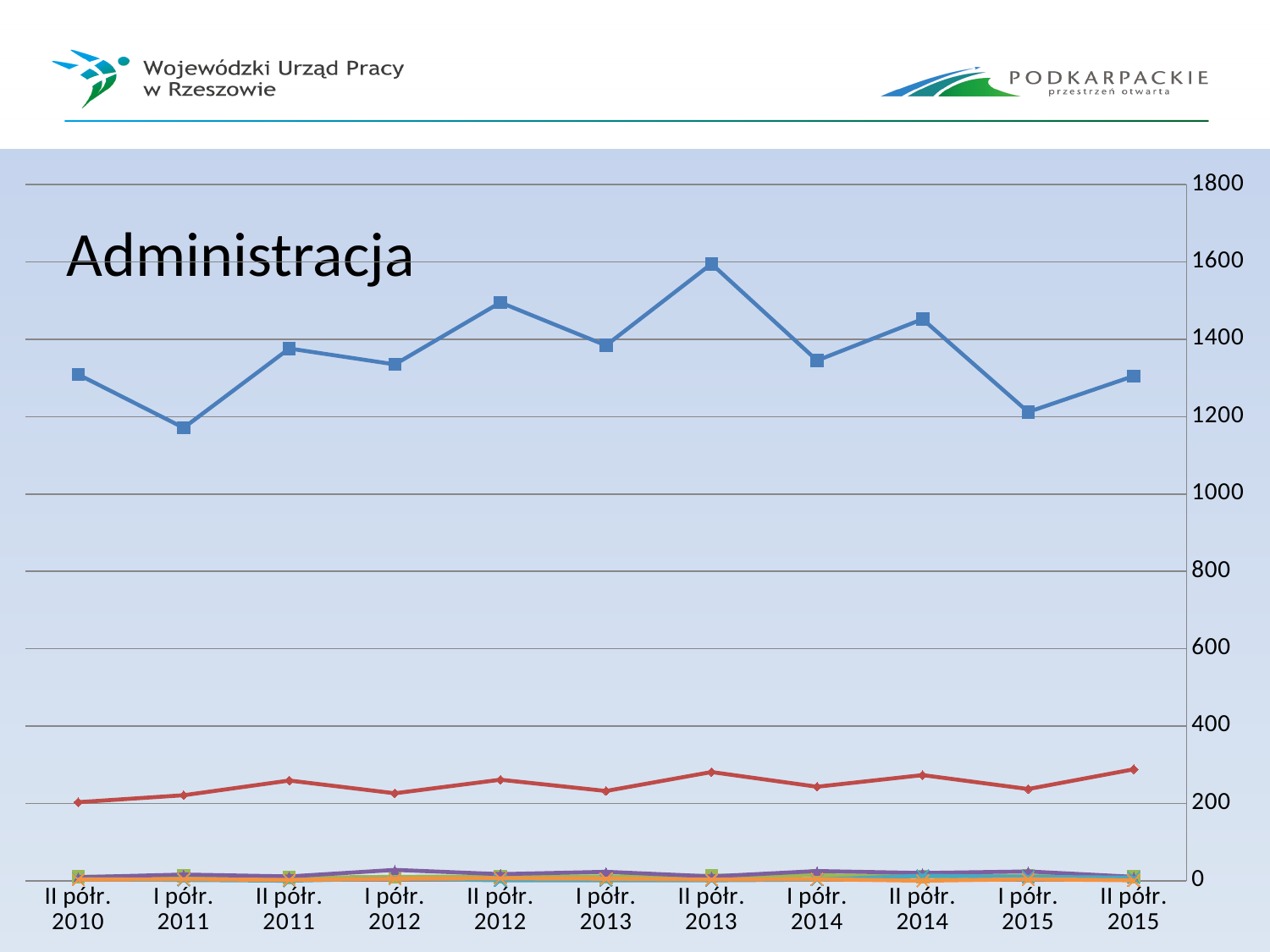
Does the blue line rise or fall from II półr. 2013 to I półr. 2014? fall What kind of chart is shown on the slide? line chart Which is larger for II półr. 2012: the value of the blue line or the value of the red line? the blue line What is the title of the chart? Administracja In which period does the blue (top) line reach its highest value? II półr. 2013 How many half-year periods are shown on the x axis? 11 Does the blue line rise or fall from I półr. 2015 to II półr. 2015? rise In which period does the blue (top) line reach its lowest value? I półr. 2011 Is the value of the red line for II półr. 2015 greater or less than 400? less Is the value of the blue line for I półr. 2011 greater or less than 1200? less Is the value of the red line for II półr. 2010 greater or less than 400? less